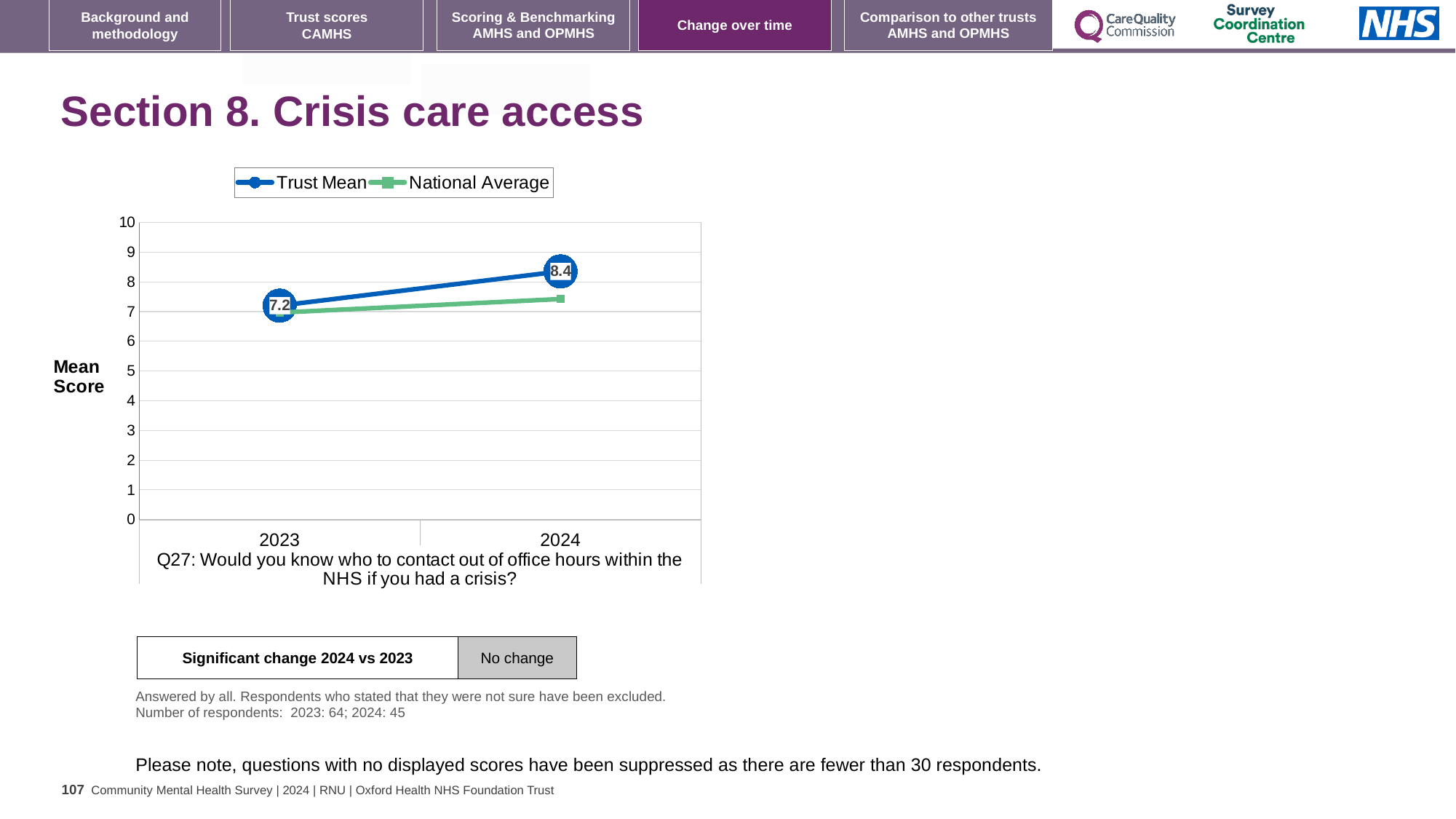
What is the Trust Mean score for 2023? 7.2 What are the two series named in the legend? Trust Mean and National Average How many series does the legend list? 2 In which year is the Trust Mean score higher? 2024 What kind of chart is shown on the slide? line chart In 2024, which is larger: the Trust Mean or the National Average? Trust Mean By how much did the Trust Mean score change from 2023 to 2024? 1.2 Is the National Average value for 2024 greater or less than 8? less Does the Trust Mean line rise or fall from 2023 to 2024? rise What is the label on the y axis of the chart? Mean Score What is the Trust Mean score for 2024? 8.4 How many years are plotted on the x axis? 2